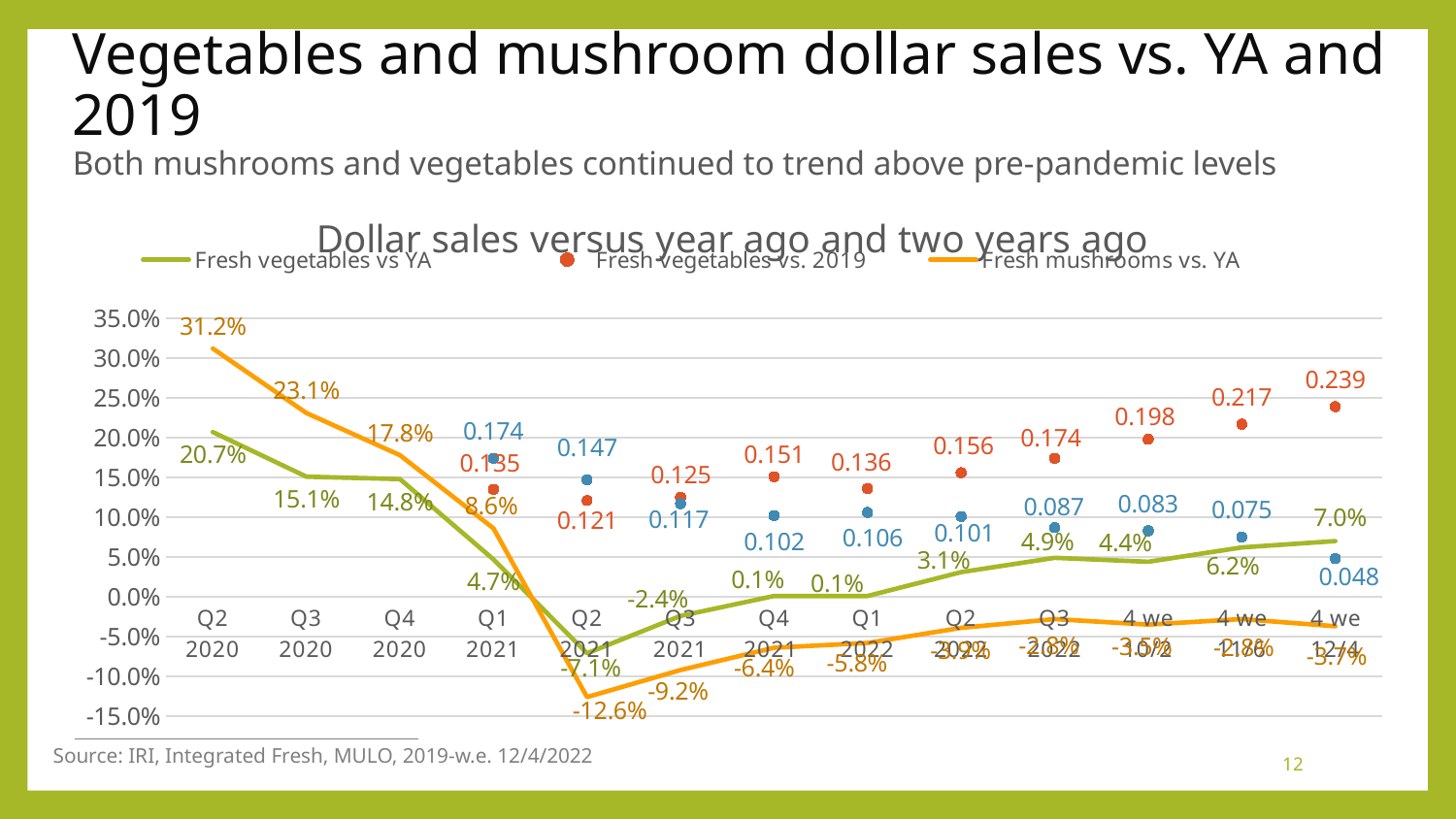
What is the value for Fresh mushrooms vs. YA in Q2 2020? 31.2% Does Fresh vegetables vs. 2019 rise or fall from Q1 2022 to the last period on the chart? rise In which period is Fresh vegetables vs YA at its lowest? Q2 2021 What is the value for Fresh mushrooms vs. YA in Q2 2021? -12.6% What kind of chart is shown on the slide? line chart How many series does the chart legend list? 3 In which period is Fresh mushrooms vs. YA at its highest? Q2 2020 What is the value for Fresh vegetables vs. 2019 in Q2 2021? 0.121 What is the value for Fresh vegetables vs YA in Q2 2020? 20.7% By how many percentage points does Fresh mushrooms vs. YA exceed Fresh vegetables vs YA in Q2 2020? 10.5 percentage points In which period is Fresh mushrooms vs. YA at its lowest? Q2 2021 In Q3 2020, which is larger: Fresh mushrooms vs. YA or Fresh vegetables vs YA? Fresh mushrooms vs. YA